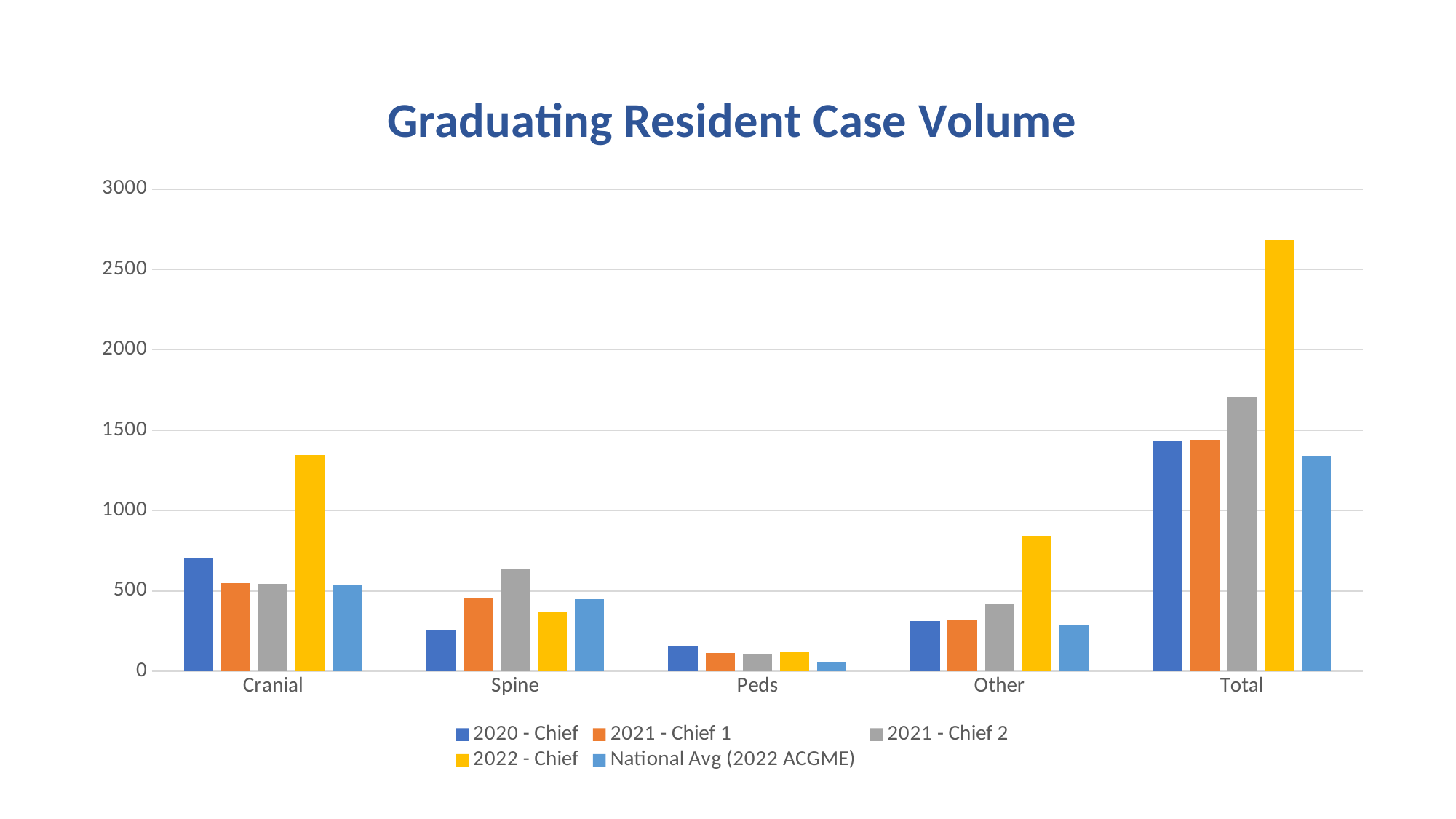
Is the value for 2022 - Chief in the Total category greater or less than 2500? greater Is the value for National Avg (2022 ACGME) in the Total category greater or less than 1500? less In the Spine category, which is larger: 2021 - Chief 2 or 2020 - Chief? 2021 - Chief 2 Which series has the highest value in the Total category? 2022 - Chief How many series does the legend list? 5 Is the value for 2020 - Chief in the Cranial category greater or less than 500? greater How many categories are shown on the x axis? 5 What kind of chart is shown on the slide? bar chart Which series has the lowest value in the Peds category? National Avg (2022 ACGME) Which series has the highest value in the Other category? 2022 - Chief What is the title of the chart? Graduating Resident Case Volume